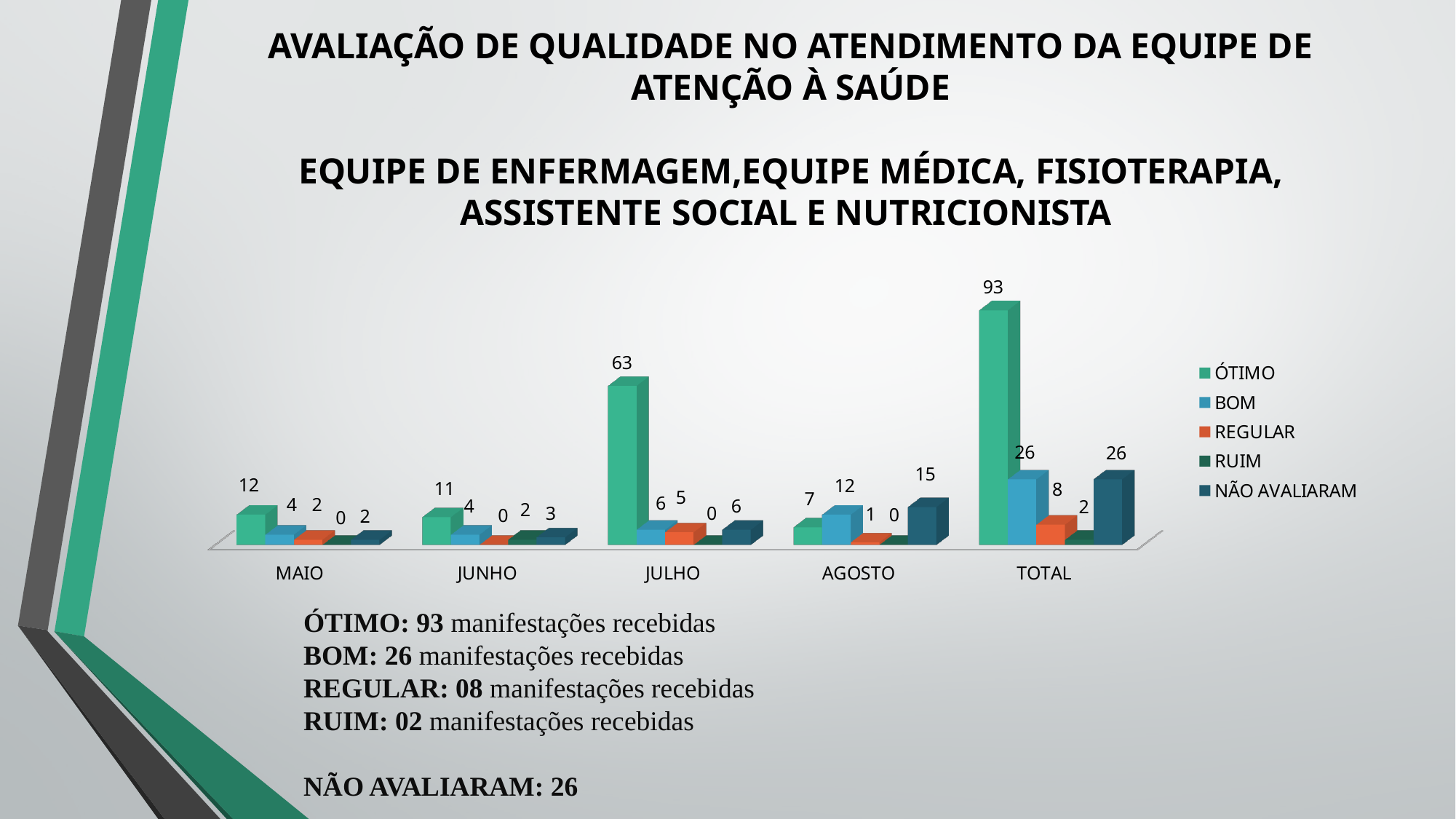
What kind of chart is shown on the slide? Bar chart Which series is shown in orange in the legend? REGULAR How many series does the legend list? 5 Which month has the lowest ÓTIMO value (excluding TOTAL)? AGOSTO What is the value of REGULAR for TOTAL? 8 What is the value of BOM for MAIO? 4 What is the value of ÓTIMO for JULHO? 63 Which month has the highest ÓTIMO value (excluding TOTAL)? JULHO What is the difference between the ÓTIMO values for JULHO and MAIO? 51 Which is larger for AGOSTO, ÓTIMO or BOM? BOM What is the value of NÃO AVALIARAM for AGOSTO? 15 How many categories are shown on the x axis? 5